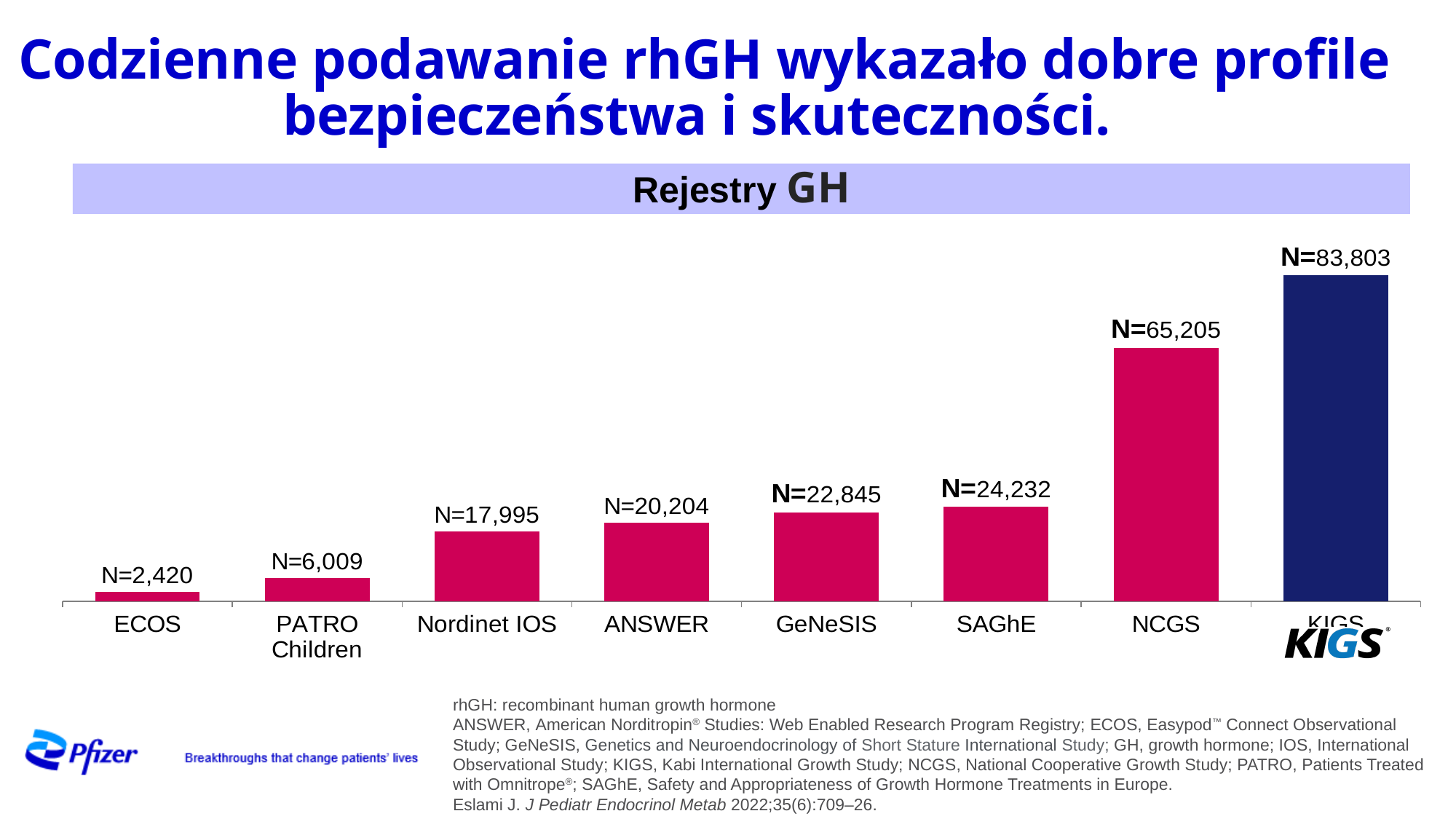
Do the N values rise or fall from left to right across the chart? Rise How many registries are shown in the chart? 8 What is the N value shown for the NCGS registry? N=65,205 What is the N value shown for the KIGS registry? N=83,803 What is the N value shown for the ECOS registry? N=2,420 Which registry has the lowest N value? ECOS What is the difference in N between PATRO Children and ECOS? 3,589 Which registry has the highest N value? KIGS What is the N value shown for the SAGhE registry? N=24,232 What kind of chart is shown on the slide? Bar chart Which registry has a larger N, GeNeSIS or Nordinet IOS? GeNeSIS What is the difference in N between KIGS and NCGS? 18,598